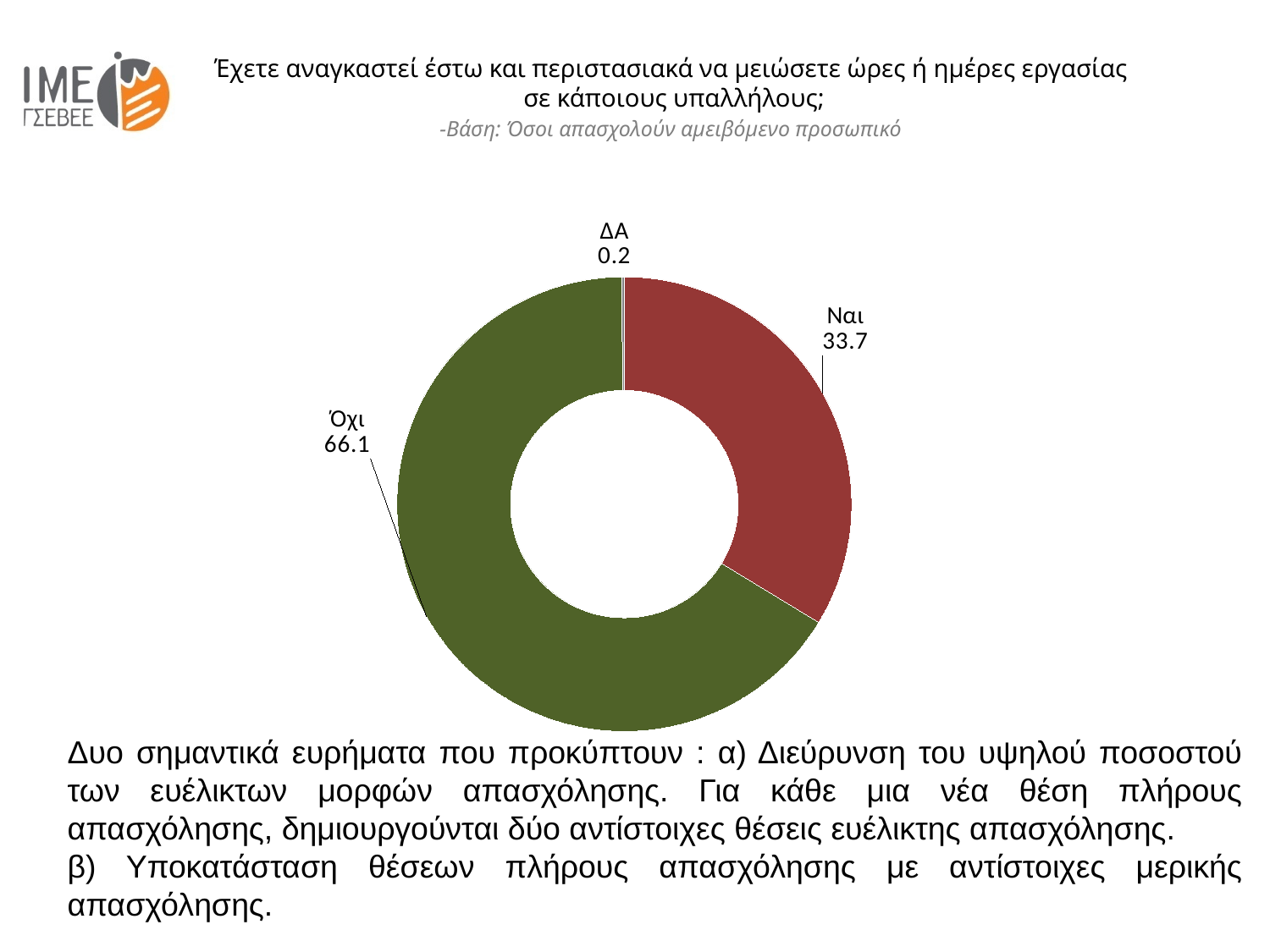
What is the difference between the values for Όχι and Ναι? 32.4 How many categories are shown in the chart? 3 What is the difference between the values for Ναι and ΔΑ? 33.5 Which category has the smallest share of the chart? ΔΑ What value is shown for Όχι? 66.1 Which category has the largest share of the chart? Όχι What kind of chart is shown on the slide? Doughnut chart Which is larger, the value for Ναι or the value for Όχι? Όχι What value is shown for Ναι? 33.7 What value is shown for ΔΑ? 0.2 What colour is the Ναι slice? Red What colour is the Όχι slice? Green